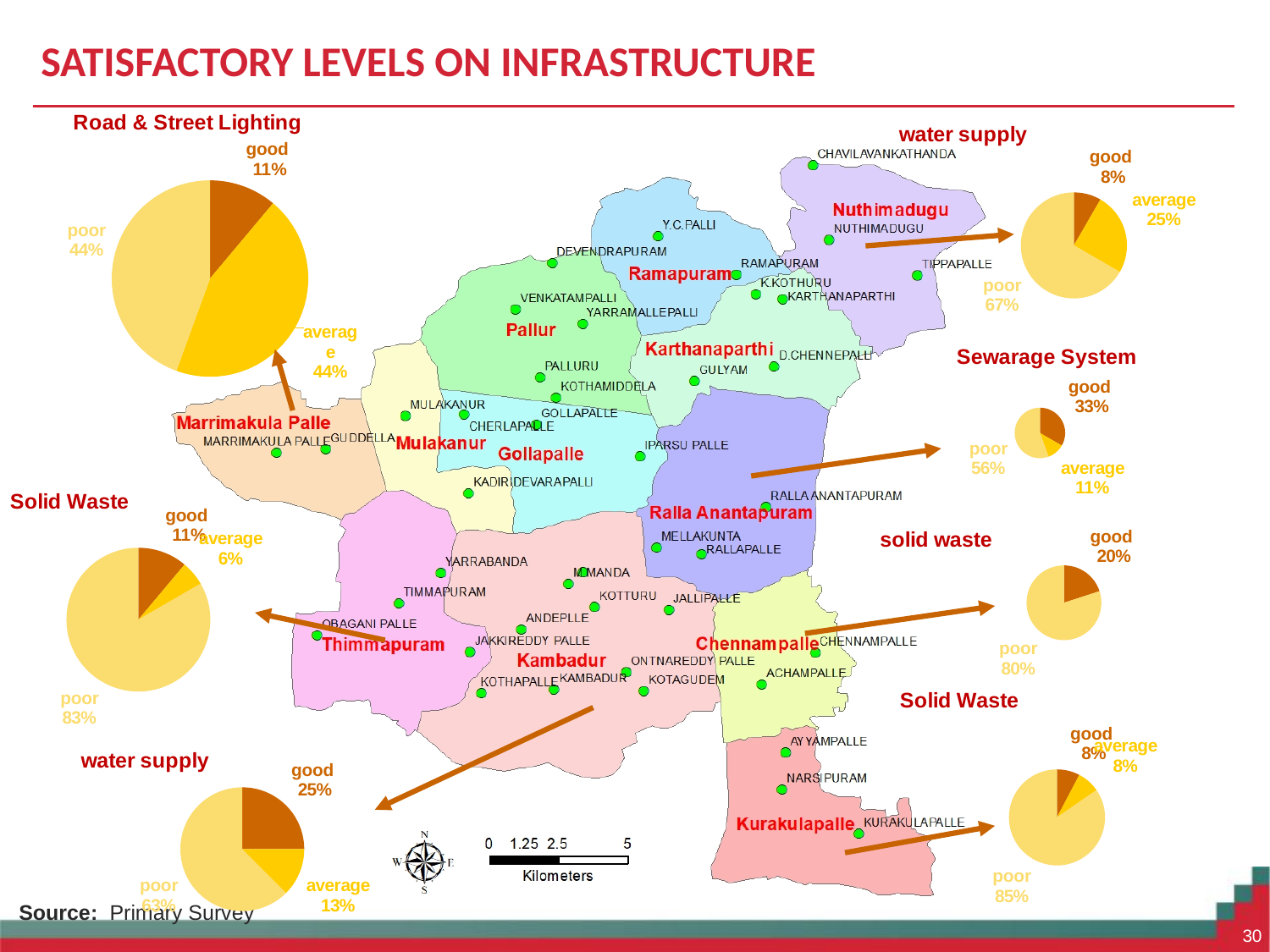
In the Sewarage System pie chart on the right, what share is labelled 'good'? 33% In the water supply pie chart at the top right (next to Nuthimadugu), what share is labelled 'poor'? 67% In the Solid Waste pie chart on the left (next to Thimmapuram), what share is labelled 'poor'? 83% What type of chart is used to show the satisfaction levels on this slide? pie chart In the Road & Street Lighting pie chart at the top left, what share is labelled 'poor'? 44% In the water supply pie chart at the top right (next to Nuthimadugu), which category has the smallest share? good In the Road & Street Lighting pie chart at the top left, what share is labelled 'good'? 11% In the water supply pie chart at the bottom left (next to Kambadur), what share is labelled 'good'? 25% In the Solid Waste pie chart on the left (next to Thimmapuram), which is larger, 'good' or 'average'? good In the Sewarage System pie chart on the right, what is the difference between the 'poor' and 'average' shares? 45% In the Solid Waste pie chart at the bottom right (next to Kurakulapalle), what share is labelled 'poor'? 85% In the solid waste pie chart on the right (next to Chennampalle), what share is labelled 'good'? 20%